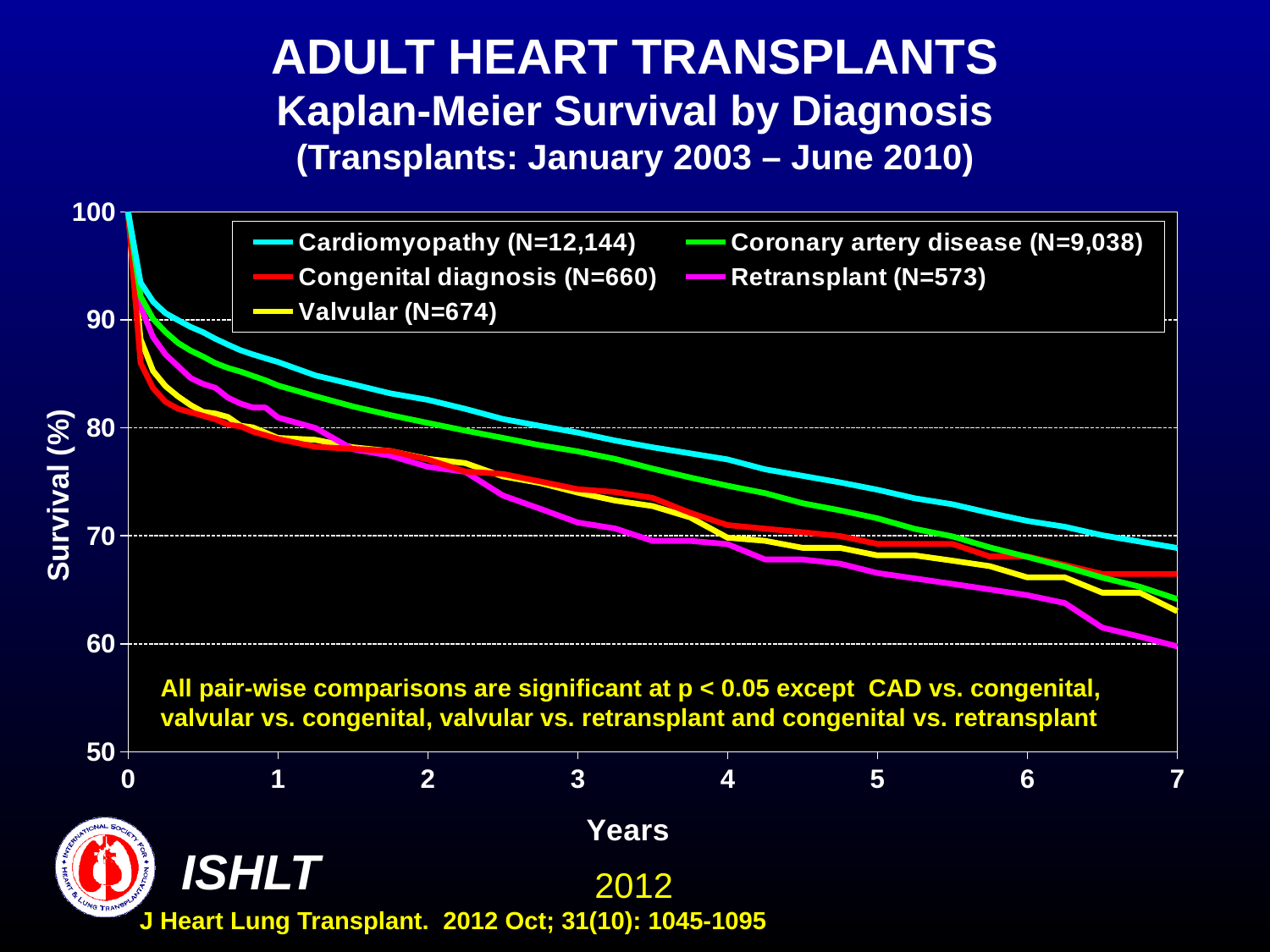
At 7 years, which has higher survival: Cardiomyopathy or Retransplant? Cardiomyopathy Do the survival curves rise or fall as years increase? Fall Is the survival for Cardiomyopathy at 4 years greater or less than 80? less Which diagnosis group has the highest survival at 7 years? Cardiomyopathy Which diagnosis group has the lowest survival at 7 years? Retransplant What kind of chart is shown on the slide? Line chart Is the survival for Cardiomyopathy at 7 years greater or less than 70? less Is the survival for Coronary artery disease at 1 year greater or less than 80? greater What is the N for the Cardiomyopathy group shown in the legend? 12,144 What is the label of the y axis? Survival (%) How many series does the legend list? 5